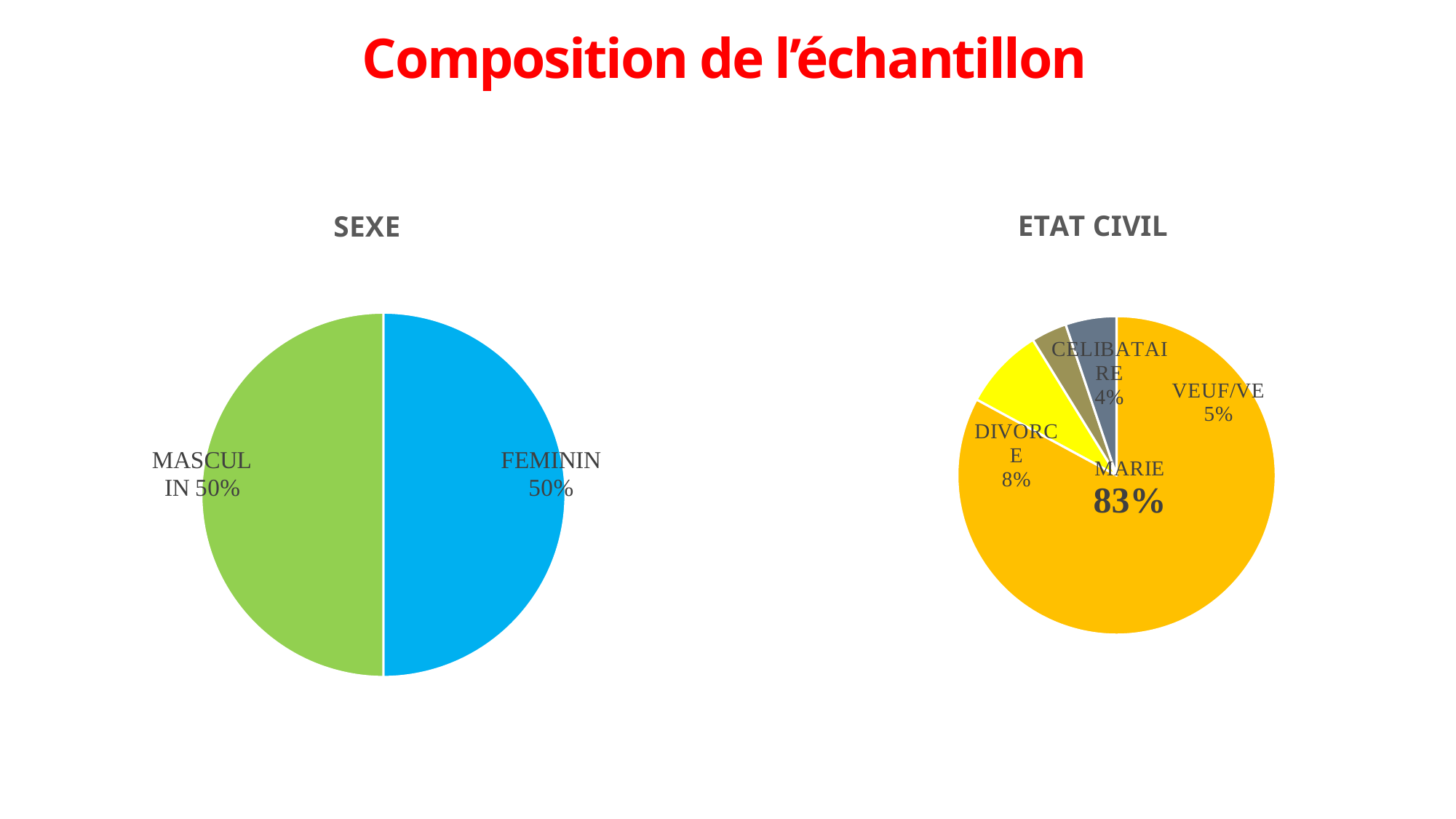
How many categories does the ETAT CIVIL chart show? 4 In the ETAT CIVIL chart, what is the difference between the MARIE and DIVORCE shares? 75% In the ETAT CIVIL chart, what share is MARIE? 83% In the ETAT CIVIL chart, which category has the largest share? MARIE What kind of chart is the SEXE chart? Pie chart In the ETAT CIVIL chart, which is larger, VEUF/VE or DIVORCE? DIVORCE In the SEXE chart, what share of the sample is FEMININ? 50% In the SEXE chart, what share of the sample is MASCULIN? 50% In the ETAT CIVIL chart, what share is CELIBATAIRE? 4% In the ETAT CIVIL chart, which category has the smallest share? CELIBATAIRE In the ETAT CIVIL chart, what share is DIVORCE? 8% In the ETAT CIVIL chart, what share is VEUF/VE? 5%